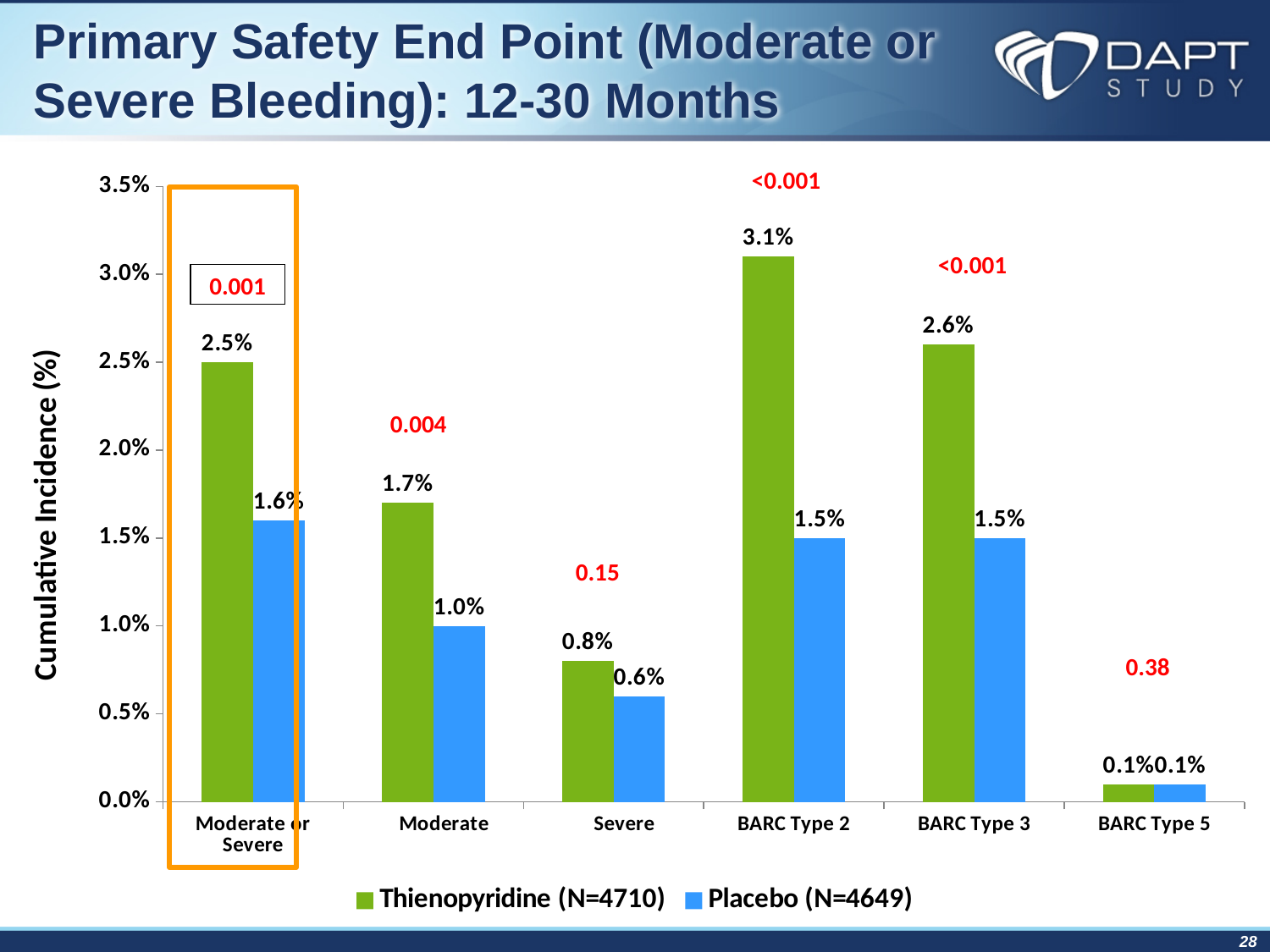
Which category has the highest Thienopyridine value? BARC Type 2 What is the label of the y axis? Cumulative Incidence (%) What is the cumulative incidence for Thienopyridine in the Moderate or Severe category? 2.5% What p-value is shown above the BARC Type 5 bars? 0.38 How many categories are shown on the x axis? 6 How many series does the legend list? 2 What is the cumulative incidence for Placebo in the BARC Type 2 category? 1.5% What is the difference between the Thienopyridine and Placebo values in the BARC Type 3 category? 1.1% What kind of chart is shown on the slide? Bar chart Which is larger in the Moderate category, the Thienopyridine value or the Placebo value? Thienopyridine Which category has the lowest Placebo value? BARC Type 5 What is the cumulative incidence for Placebo in the Severe category? 0.6%